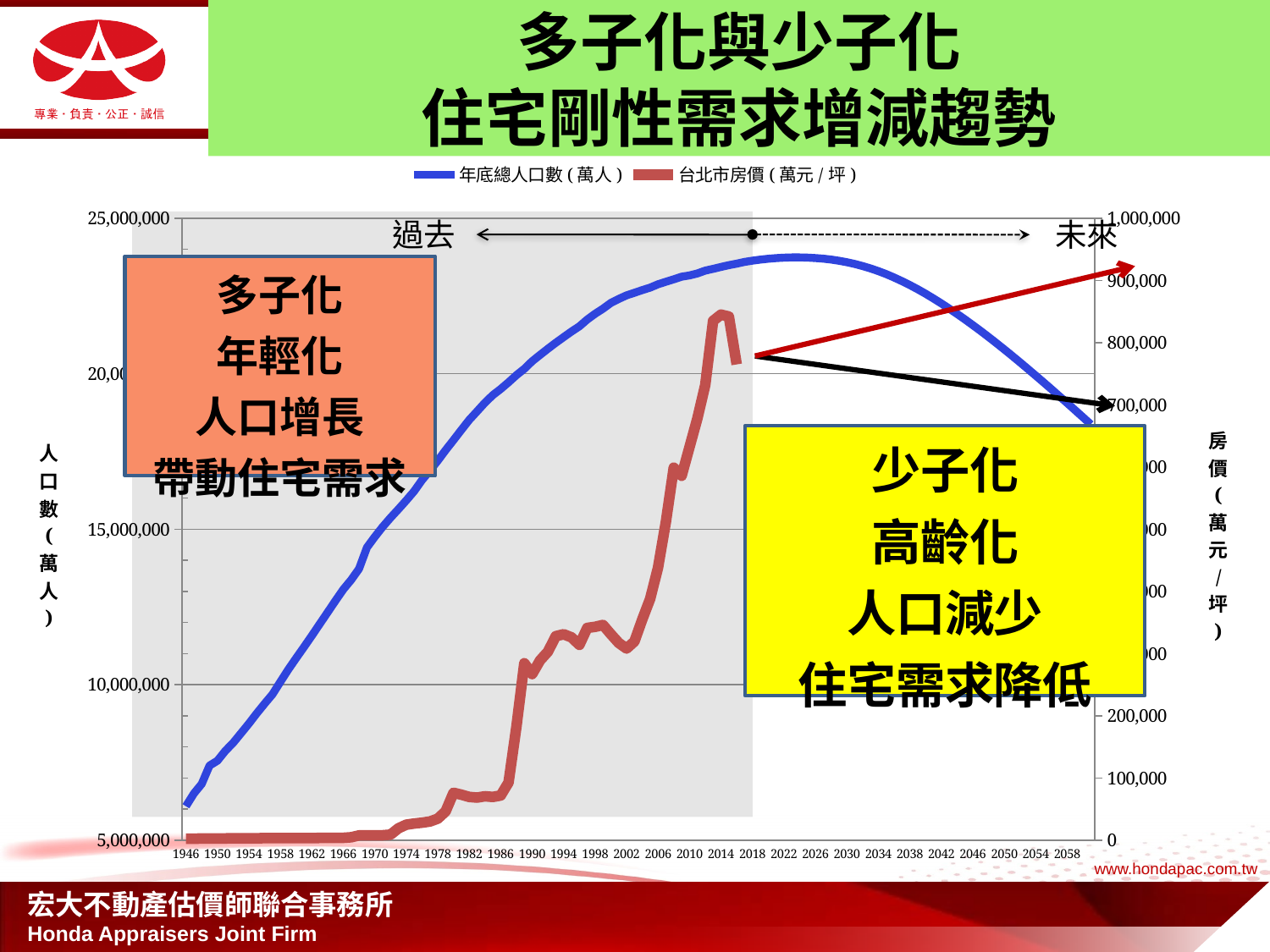
Is the value of 年底總人口數 in 2026 greater or less than 20,000,000? greater Which is larger, 台北市房價 in 1990 or in 2014? 2014 Which series is drawn in red in the chart? 台北市房價(萬元/坪) Is the value of 台北市房價 in 1970 greater or less than 100,000? less Is the value of 台北市房價 in 2014 greater or less than 700,000? greater How many series does the chart legend list? 2 What kind of chart is shown on the slide? line chart Does the 年底總人口數 line rise or fall from 2030 to 2058? fall Does the 年底總人口數 line rise or fall from 1946 to 2010? rise Which series is drawn in blue in the chart? 年底總人口數(萬人) Which is larger, 年底總人口數 in 1946 or in 2026? 2026